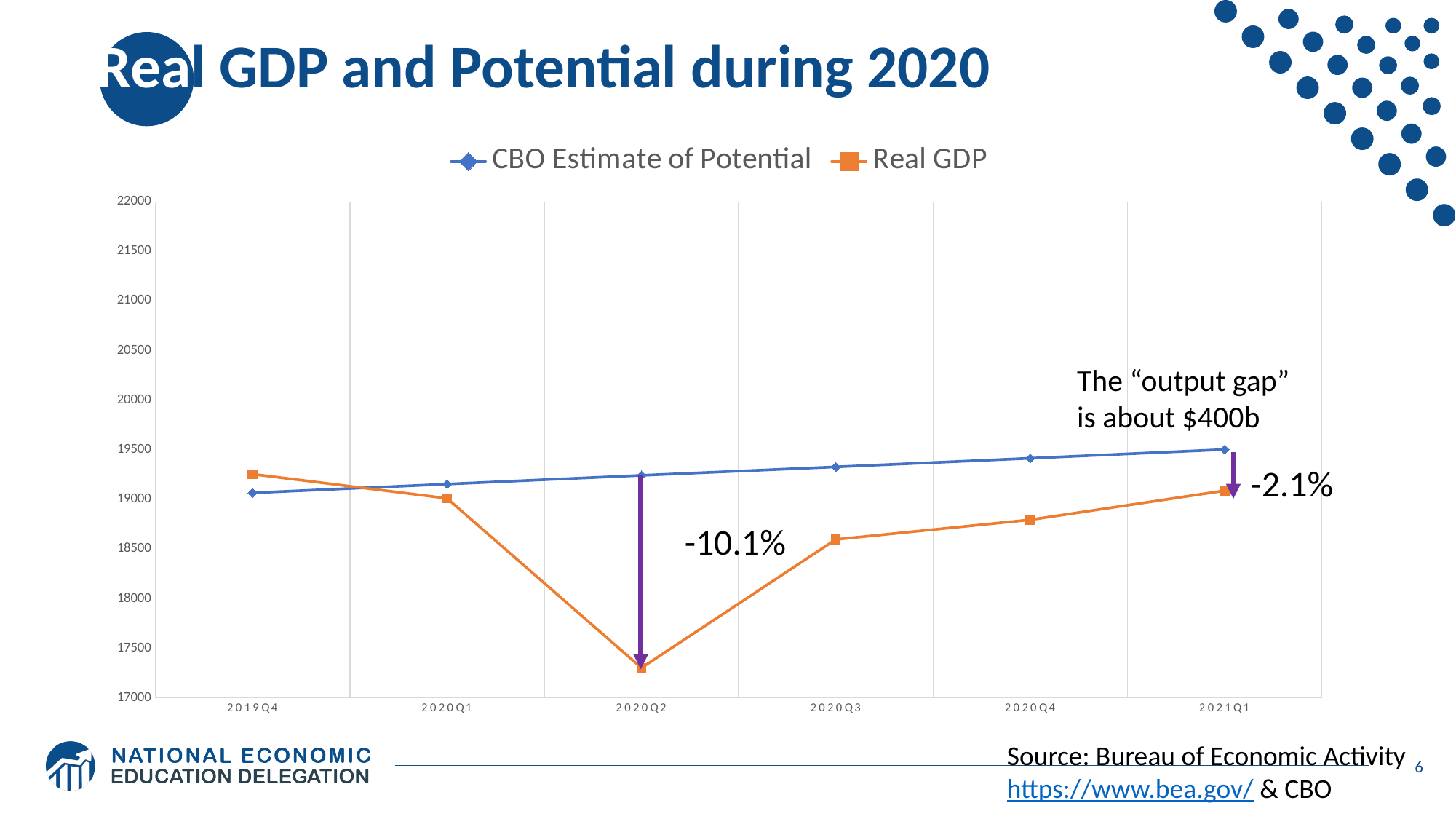
At 2020Q2, which series has the higher value, CBO Estimate of Potential or Real GDP? CBO Estimate of Potential In which quarter is the CBO Estimate of Potential at its highest? 2021Q1 How many quarters are plotted along the x axis? 6 Is the Real GDP value for 2020Q4 greater or less than 19000? less Is the Real GDP value for 2020Q2 greater or less than 17500? less What kind of chart is shown on the slide? line chart Is the Real GDP value for 2020Q3 greater or less than 18000? greater Does the CBO Estimate of Potential rise or fall from 2019Q4 to 2021Q1? rise How many series does the legend list? 2 In which quarter is Real GDP at its lowest? 2020Q2 At 2019Q4, which series has the higher value, CBO Estimate of Potential or Real GDP? Real GDP What percentage gap is annotated next to the arrow at 2020Q2? -10.1%